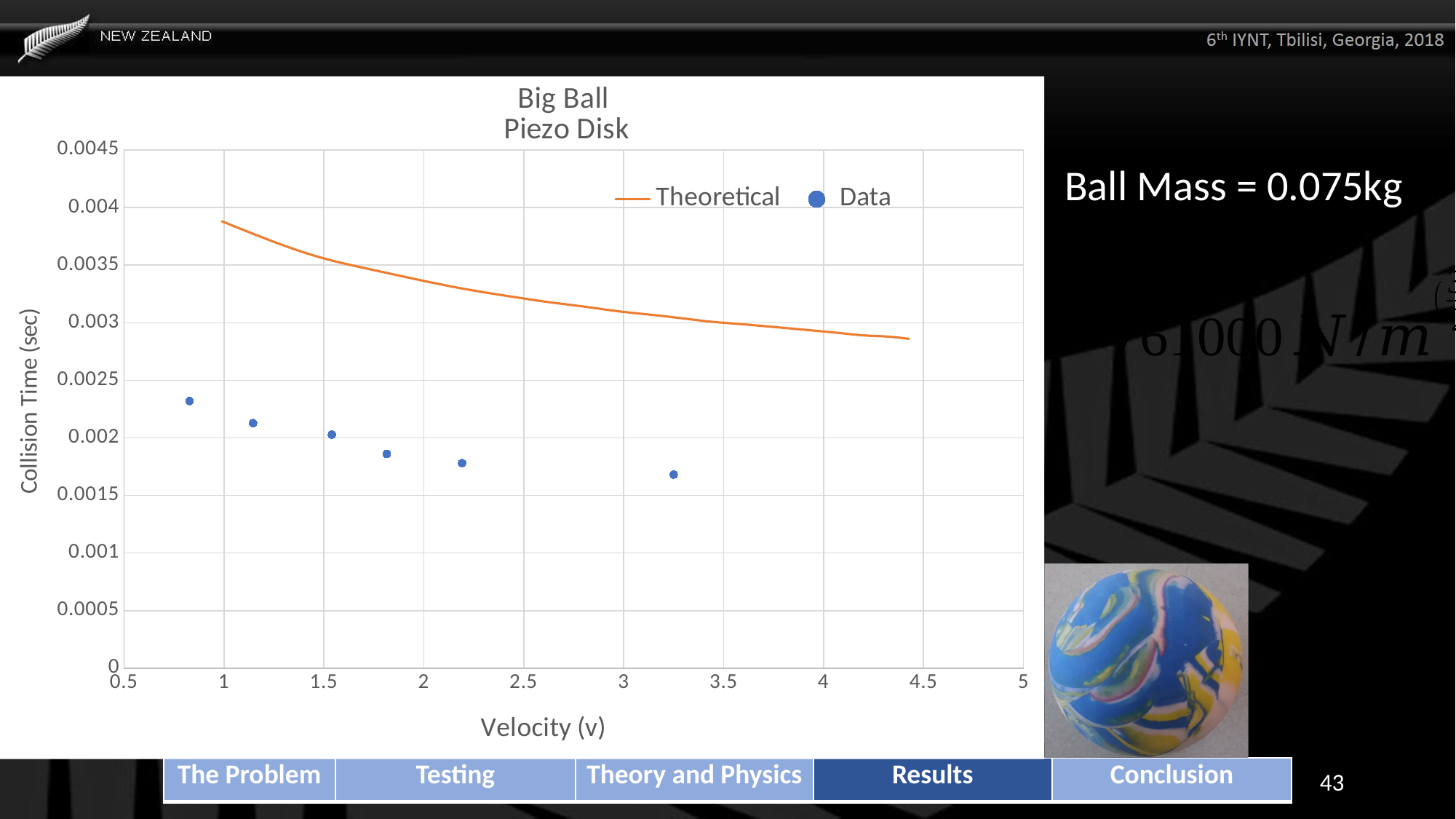
Is the collision time of the Data point at the lowest velocity (around 0.8) greater or less than 0.002? greater Is the Theoretical collision time at velocity 2 greater or less than 0.003? greater Is the collision time of the Data point at the highest velocity (around 3.25) greater or less than 0.002? less At velocity 2, which is larger: the Theoretical collision time or the Data collision time? Theoretical What kind of chart is shown on the slide? scatter chart Does the Theoretical line rise or fall as velocity increases? fall What is the label of the vertical axis? Collision Time (sec) Do the Data points rise or fall as velocity increases? fall How many Data points are plotted on the chart? 6 What is the title of the chart? Big Ball Piezo Disk How many series does the chart legend list? 2